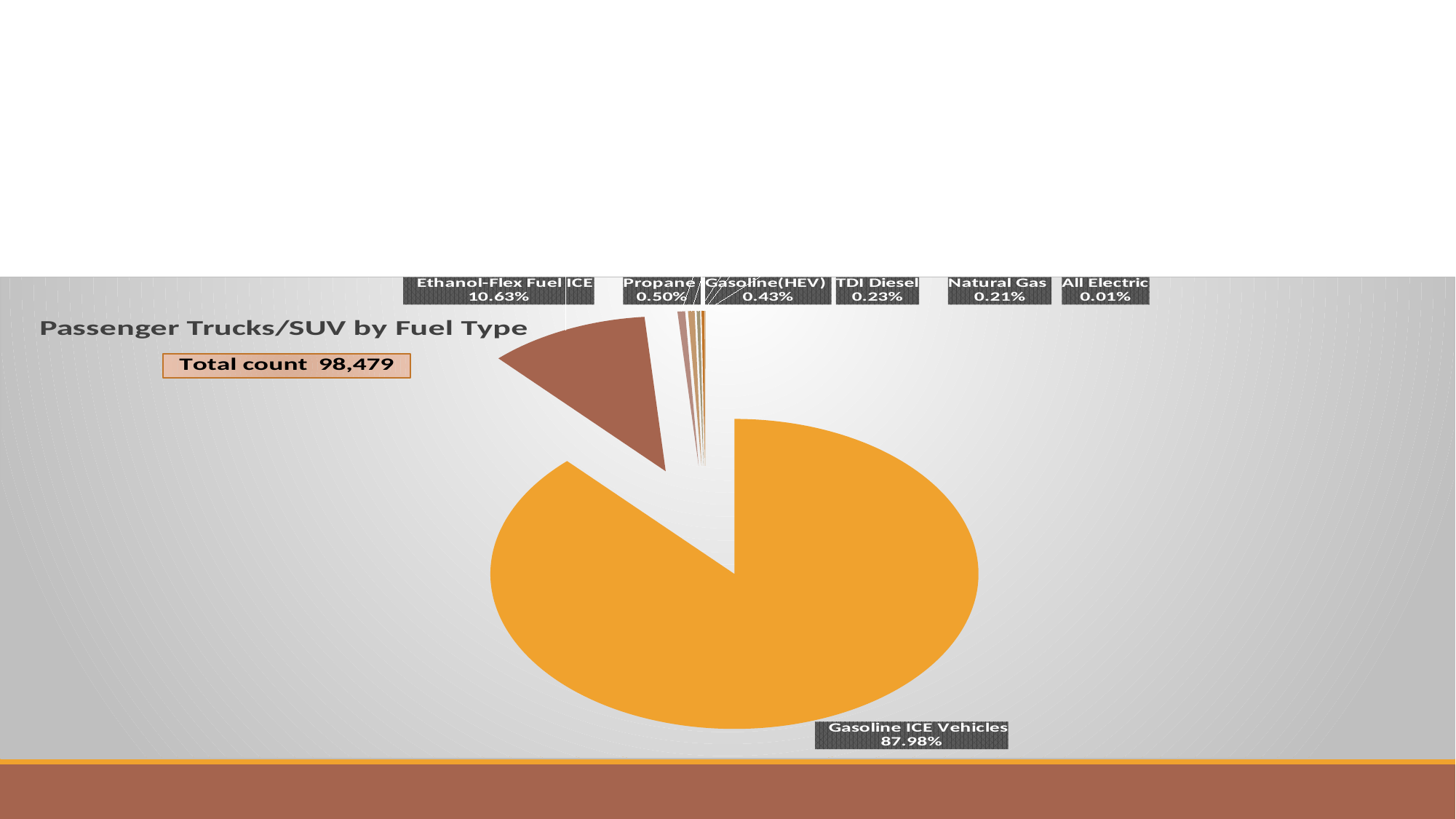
What kind of chart is shown on the slide? Pie chart Which fuel type has the largest slice? Gasoline ICE Vehicles What is the value shown for Propane? 0.50% What is the value shown for TDI Diesel? 0.23% What share of the pie is Ethanol-Flex Fuel ICE? 10.63% What share of the pie is Gasoline ICE Vehicles? 87.98% How many fuel type categories are shown in the pie chart? 7 Which fuel type has the smallest slice? All Electric What is the value shown for Natural Gas? 0.21% What is the difference between the Gasoline ICE Vehicles share and the Ethanol-Flex Fuel ICE share? 77.35% What is the value shown for Gasoline(HEV)? 0.43% What is the title of the chart? Passenger Trucks/SUV by Fuel Type